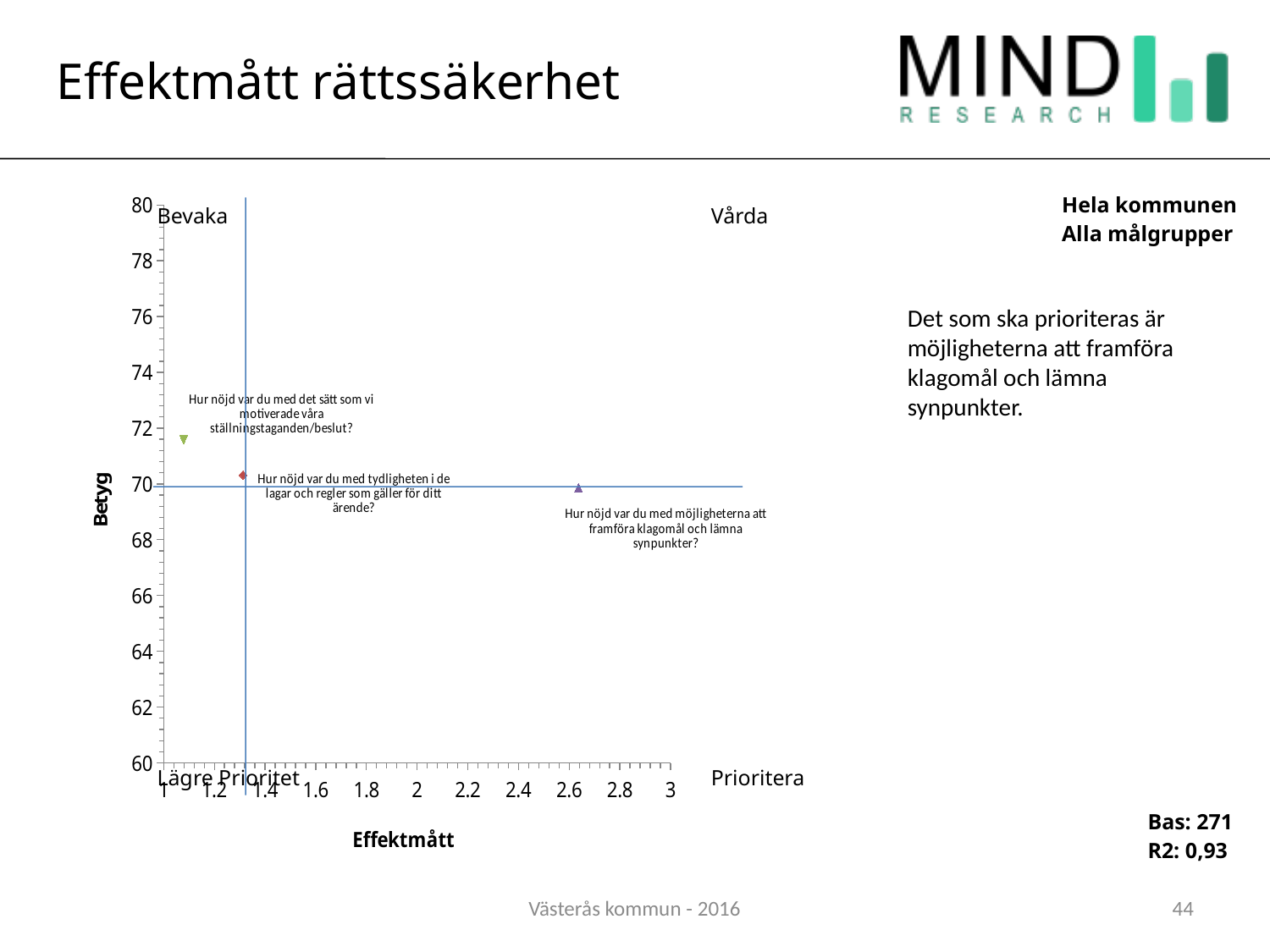
What is the title of the vertical axis of the chart? Betyg Is the Betyg value for 'Hur nöjd var du med det sätt som vi motiverade våra ställningstaganden/beslut?' greater or less than 70? greater What kind of chart is shown on the slide? scatter chart What label appears in the top-right quadrant of the chart? Vårda Is the Betyg value for 'Hur nöjd var du med möjligheterna att framföra klagomål och lämna synpunkter?' greater or less than 72? less Which question has the lowest Effektmått value in the chart? Hur nöjd var du med det sätt som vi motiverade våra ställningstaganden/beslut? Which has a higher Effektmått value: 'Hur nöjd var du med möjligheterna att framföra klagomål och lämna synpunkter?' or 'Hur nöjd var du med tydligheten i de lagar och regler som gäller för ditt ärende?'? Hur nöjd var du med möjligheterna att framföra klagomål och lämna synpunkter? Is the Effektmått value for 'Hur nöjd var du med tydligheten i de lagar och regler som gäller för ditt ärende?' greater or less than 2? less Which question has the highest Betyg value in the chart? Hur nöjd var du med det sätt som vi motiverade våra ställningstaganden/beslut? How many data points are plotted in the chart? 3 Which question has the highest Effektmått value in the chart? Hur nöjd var du med möjligheterna att framföra klagomål och lämna synpunkter?